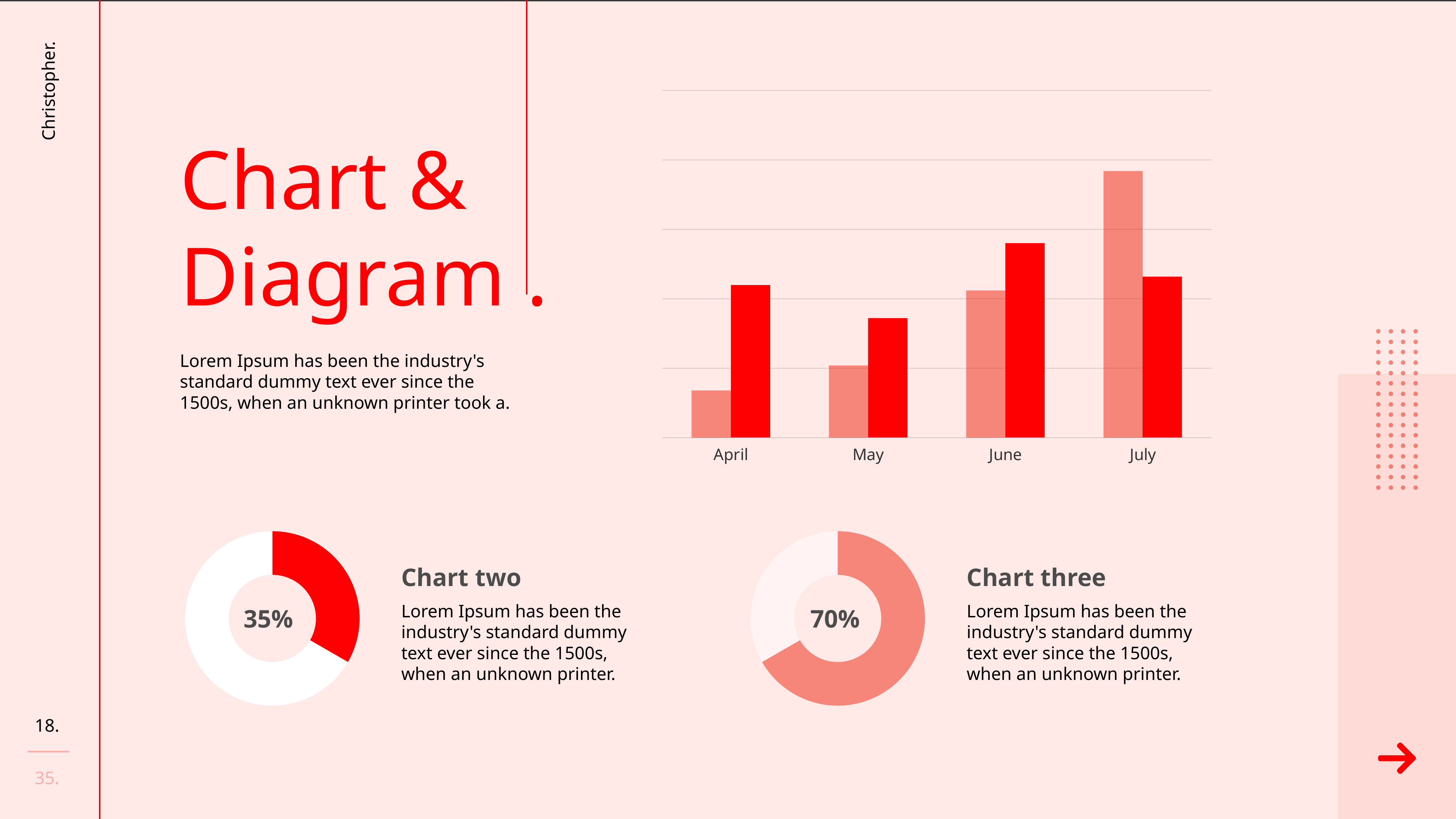
In the bar chart at the top right, which month has the tallest dark red bar? June What percentage is shown in the centre of the donut chart labelled 'Chart two'? 35% In the bar chart at the top right, which month has the tallest light red bar? July What percentage is shown in the centre of the donut chart labelled 'Chart three'? 70% In the bar chart at the top right, which month has the shortest light red bar? April How many categories are shown on the x axis of the bar chart at the top right? 4 In the bar chart at the top right, for July, which bar is taller: the light red bar or the dark red bar? the light red bar In the bar chart at the top right, which month has the shortest dark red bar? May In the bar chart at the top right, for April, which bar is taller: the light red bar or the dark red bar? the dark red bar What kind of chart is the chart at the top right of the slide? bar chart Which donut chart shows the larger percentage, 'Chart two' or 'Chart three'? Chart three In the bar chart at the top right, do the light red bars rise or fall from April to July? rise